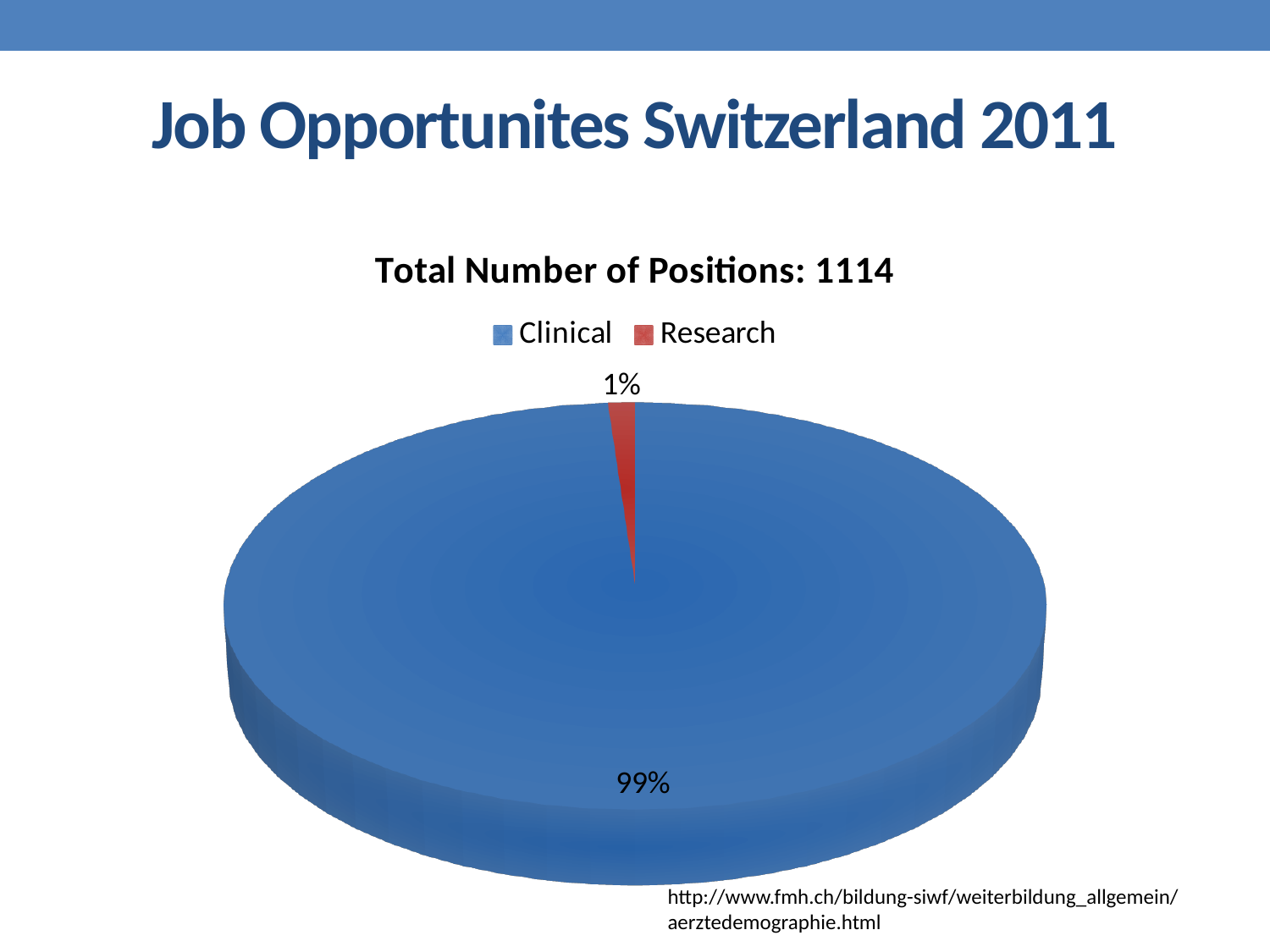
What kind of chart is shown on the slide? pie chart What share of positions is Clinical? 99% Which category has the largest share of the pie? Clinical What is the title of the chart? Total Number of Positions: 1114 What is the difference in percentage points between the Clinical and Research shares? 98 How many entries does the legend list? 2 Which is larger, the Clinical share or the Research share? Clinical What colour is the Research slice? red Which category has the smallest share of the pie? Research How many categories does the pie chart show? 2 What share of positions is Research? 1%